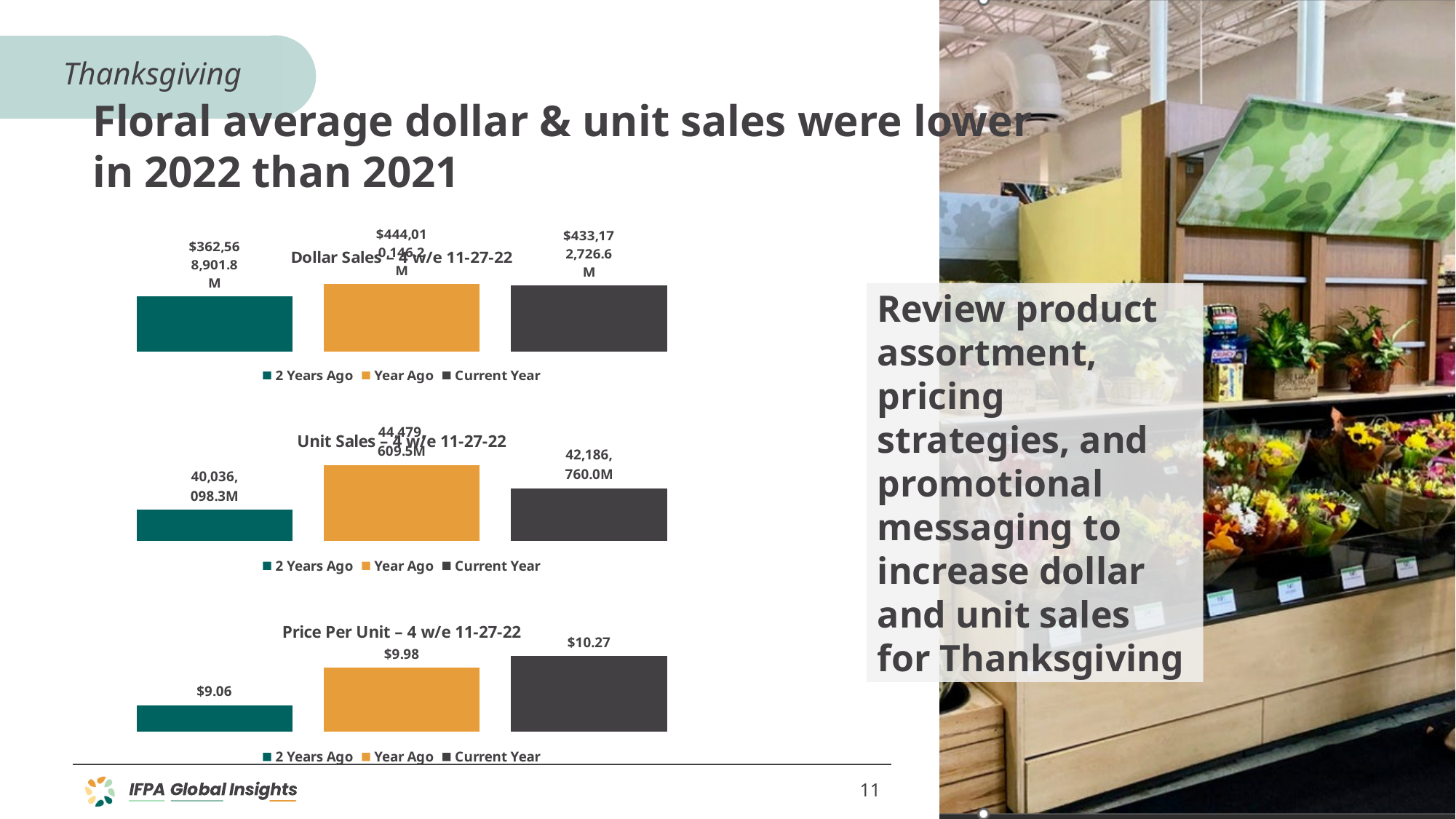
In the Price Per Unit chart, what is the value for 2 Years Ago? $9.06 In the Unit Sales chart, which period has the lowest value? 2 Years Ago In the Dollar Sales chart, which period has the lowest value? 2 Years Ago In the Price Per Unit chart, what is the difference between the Current Year and Year Ago values? $0.29 In the Price Per Unit chart, what is the value for Current Year? $10.27 In the Price Per Unit chart, which period has the highest value? Current Year In the Dollar Sales chart, which period has the highest value? Year Ago What kind of chart is the Unit Sales chart? bar chart How many series does the legend of the Dollar Sales chart list? 3 In the Unit Sales chart, is the value for Year Ago larger or smaller than the value for Current Year? larger In the Price Per Unit chart, what is the difference between the Current Year and 2 Years Ago values? $1.21 In the Price Per Unit chart, what is the value for Year Ago? $9.98